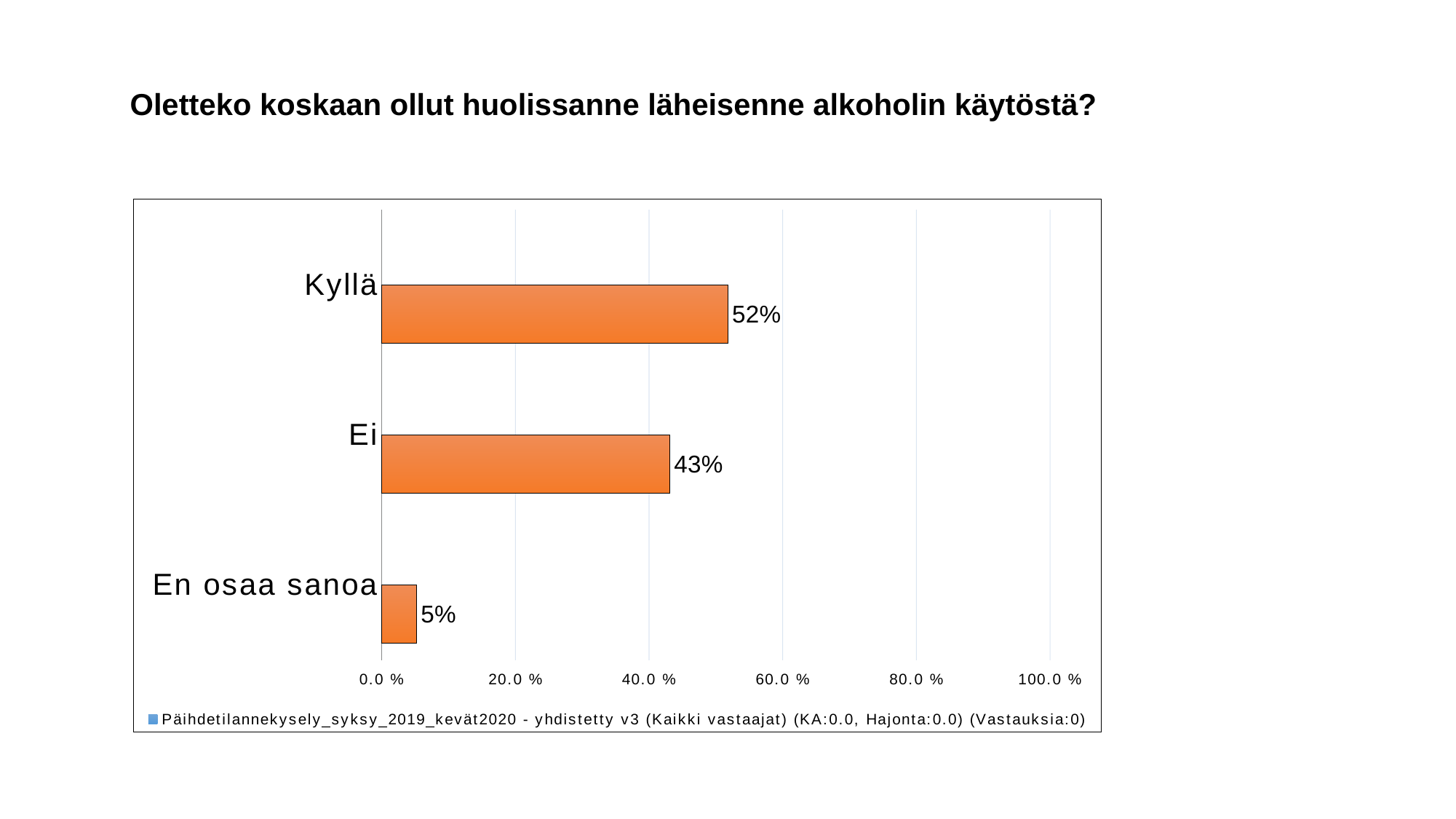
How many categories are shown in the chart? 3 What is the value for Ei? 43% How many series does the legend list? 1 What is the title of the slide above the chart? Oletteko koskaan ollut huolissanne läheisenne alkoholin käytöstä? What kind of chart is shown on the slide? bar chart Is the value for Kyllä greater or less than 40.0 %? greater What is the value for Kyllä? 52% What is the difference between the values for Kyllä and Ei? 9% Which category has the highest value? Kyllä What is the value for En osaa sanoa? 5% Which category has the lowest value? En osaa sanoa Which is larger, the value for Ei or the value for En osaa sanoa? Ei